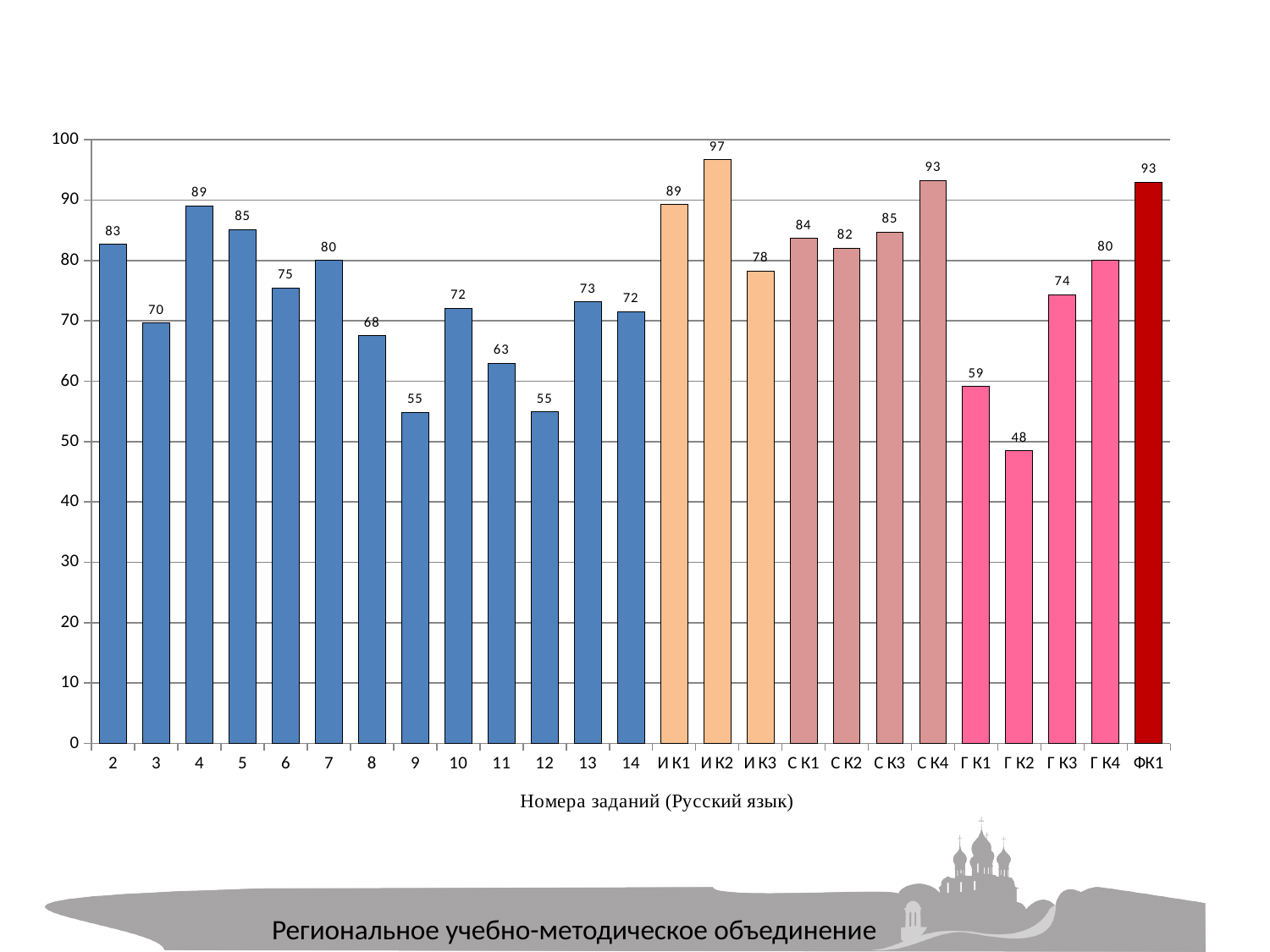
Which category has the lowest value? Г К2 Which is larger, the value for С К4 or the value for С К1? С К4 Which category has the highest value? И К2 What kind of chart is shown on the slide? bar chart What is the value for Г К2? 48 What is the difference between the values for task 2 and task 3? 13 What is the difference between the values for И К2 and Г К2? 49 What is the value for task 4? 89 Is the value for task 9 greater or less than 60? less What is the value for И К3? 78 What is the x-axis title of the chart? Номера заданий (Русский язык) How many categories are shown on the x axis? 25